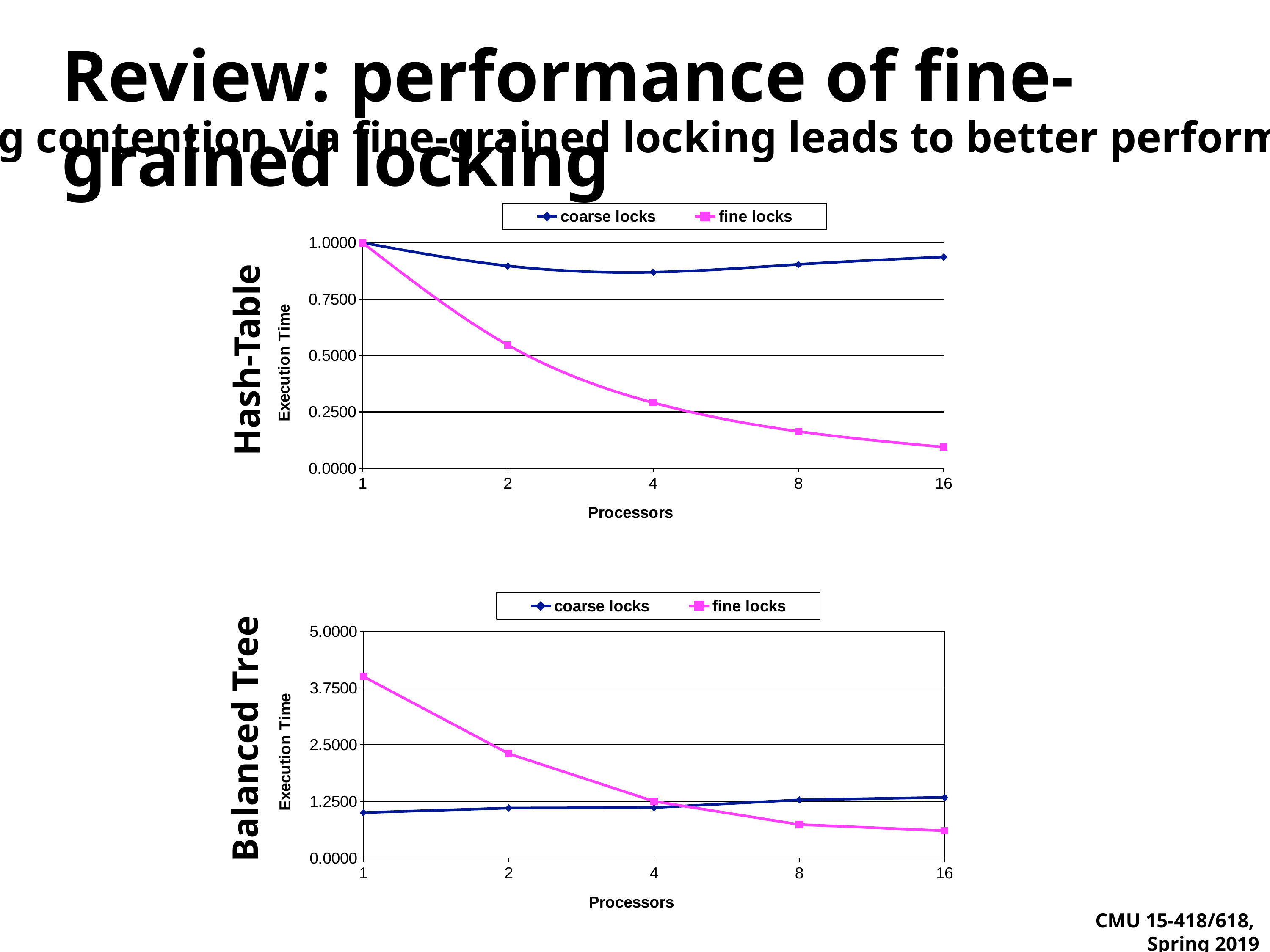
What type of chart is the Hash-Table chart? line chart In the Balanced Tree chart, does the execution time for coarse locks rise or fall as the number of processors increases? rise How many processor counts are plotted along the x axis of the Hash-Table chart? 5 How many series does the legend of the Balanced Tree chart list? 2 In the Hash-Table chart, is the execution time for coarse locks at 4 processors greater or less than 0.7500? greater In the Balanced Tree chart, which series has the higher execution time at 1 processor, coarse locks or fine locks? fine locks In the Balanced Tree chart, is the execution time for fine locks at 8 processors greater or less than 1.2500? less In the Balanced Tree chart, is the execution time for coarse locks at 1 processor greater or less than 1.2500? less In the Hash-Table chart, which series has the higher execution time at 16 processors, coarse locks or fine locks? coarse locks In the Hash-Table chart, does the execution time for fine locks rise or fall as the number of processors increases? fall